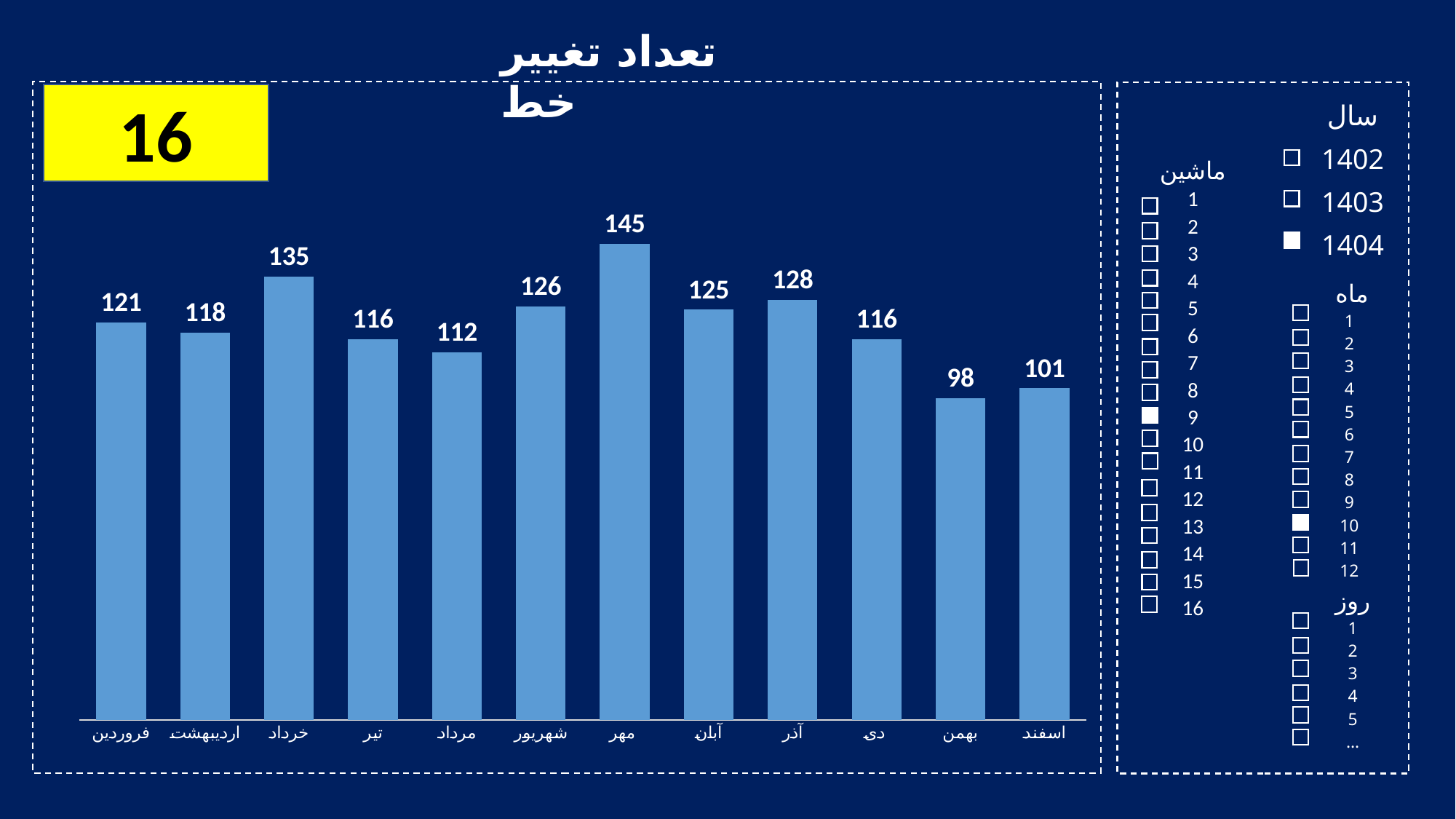
What is the value for بهمن? 98 What is the value for آذر? 128 What is the value for فروردین? 121 What is the value for مهر? 145 What is the difference between the values for خرداد and تیر? 19 What is the difference between the values for مهر and بهمن? 47 Which month has the lowest value? بهمن How many months are shown on the x axis? 12 Which is larger, the value for شهریور or the value for آبان? شهریور Which month has the highest value? مهر What is the title of the chart? تعداد تغییر خط What kind of chart is shown? bar chart